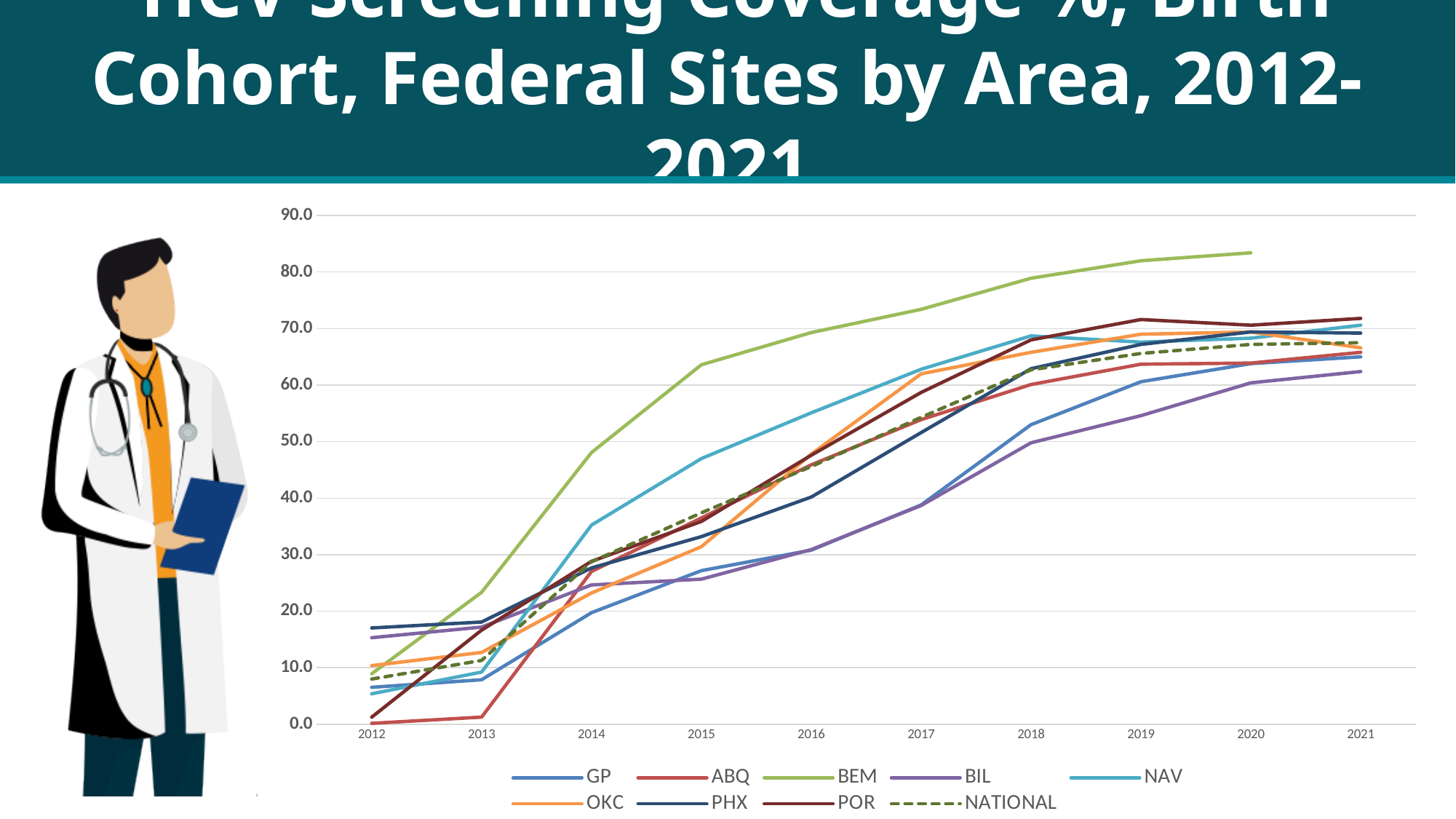
How many years are shown along the x axis? 10 What kind of chart is shown on the slide? line chart Which series has the lowest value in 2012? ABQ Is the value for BEM in 2020 greater or less than 80? greater Is the value for BEM in 2014 greater or less than 50? less Is the value for NAV in 2014 greater or less than 30? greater Which series has the highest value in 2020? BEM Does the BEM series rise or fall from 2012 to 2020? rise Which series has the highest value in 2021? POR In 2016, which is larger, the value for BEM or the value for BIL? BEM How many series does the legend list? 9